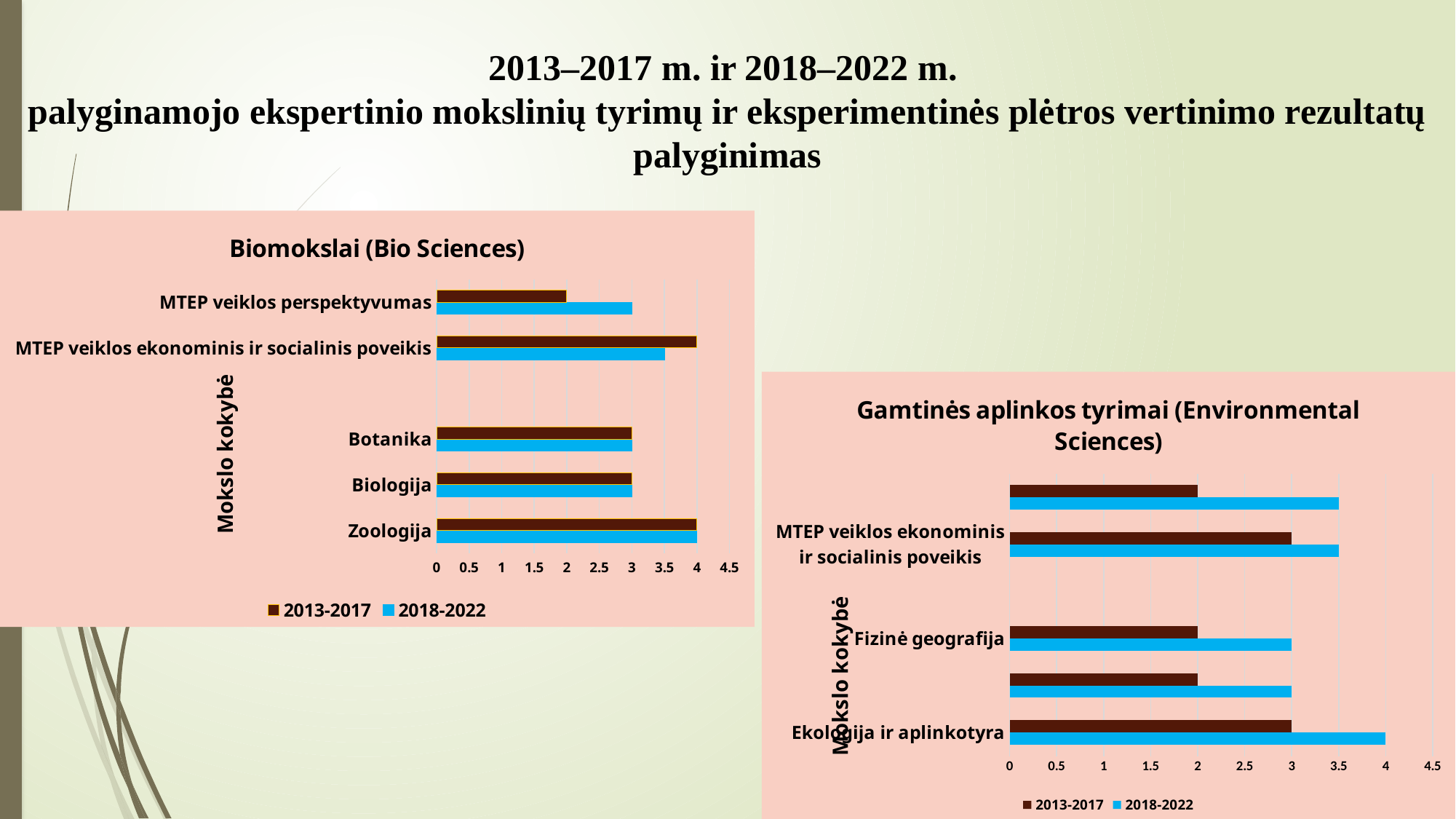
In the Gamtinės aplinkos tyrimai (Environmental Sciences) chart, what is the value for Ekologija ir aplinkotyra in 2018-2022? 4 What kind of chart is the Gamtinės aplinkos tyrimai (Environmental Sciences) chart? bar chart In the Biomokslai (Bio Sciences) chart, what is the value for MTEP veiklos ekonominis ir socialinis poveikis in 2018-2022? 3.5 In the Biomokslai (Bio Sciences) chart, what is the difference between the 2013-2017 and 2018-2022 values for MTEP veiklos perspektyvumas? 1 In the Gamtinės aplinkos tyrimai (Environmental Sciences) chart, what is the value for Fizinė geografija in 2013-2017? 2 In the Gamtinės aplinkos tyrimai (Environmental Sciences) chart, is the 2018-2022 value for Ekologija ir aplinkotyra greater or less than 3.5? greater In the Gamtinės aplinkos tyrimai (Environmental Sciences) chart, what is the difference between the 2018-2022 and 2013-2017 values for Ekologija ir aplinkotyra? 1 What is the title of the chart on the left of the slide? Biomokslai (Bio Sciences) In the Biomokslai (Bio Sciences) chart, what is the value for Zoologija in 2013-2017? 4 In the Biomokslai (Bio Sciences) chart, how many series does the legend list? 2 In the Biomokslai (Bio Sciences) chart, what is the value for MTEP veiklos perspektyvumas in 2018-2022? 3 In the Biomokslai (Bio Sciences) chart, which is larger for MTEP veiklos perspektyvumas: the 2013-2017 value or the 2018-2022 value? 2018-2022